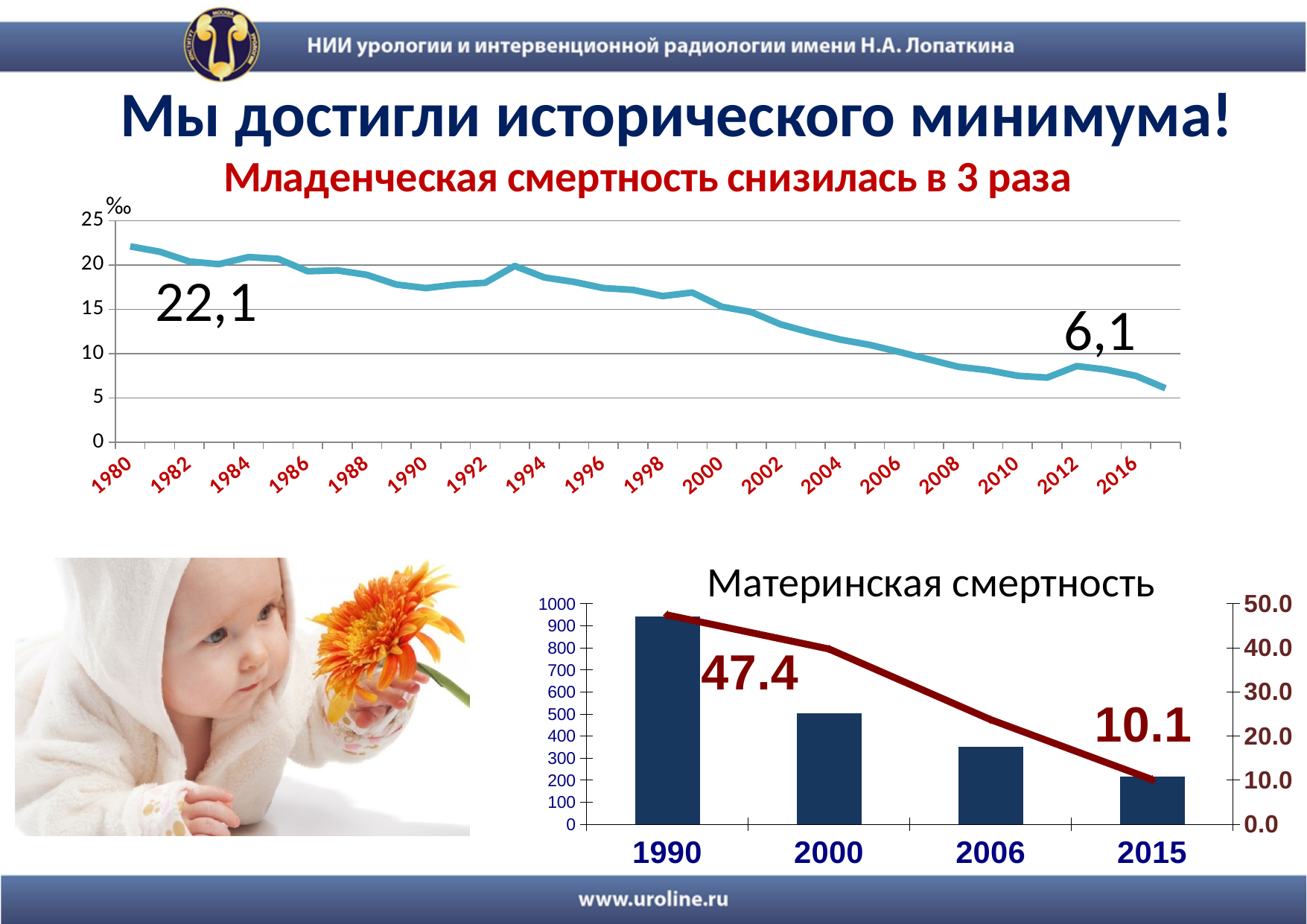
On the top chart (Младенческая смертность), is the value for 1990 greater or less than 15? greater On the top chart (Младенческая смертность), what value is labelled at the end of the line? 6,1 On the top chart (Младенческая смертность), do the values rise or fall from 1980 to the end of the series? fall On the top chart (Младенческая смертность), by how much did the labelled value fall from 22,1 to 6,1? 16 On the top chart (Младенческая смертность), is the value for 2006 greater or less than 15? less On the bottom chart (Материнская смертность), what is the difference between the labelled line values 47.4 and 10.1? 37.3 On the bottom chart (Материнская смертность), what value is labelled on the line for 2015? 10.1 On the top chart (Младенческая смертность), what value is labelled at the start of the line in 1980? 22,1 How many years (bars) are shown on the bottom chart (Материнская смертность)? 4 What unit is shown on the y axis of the top chart (Младенческая смертность)? ‰ On the bottom chart (Материнская смертность), which year has the tallest bar? 1990 On the bottom chart (Материнская смертность), what value is labelled on the line for 1990? 47.4